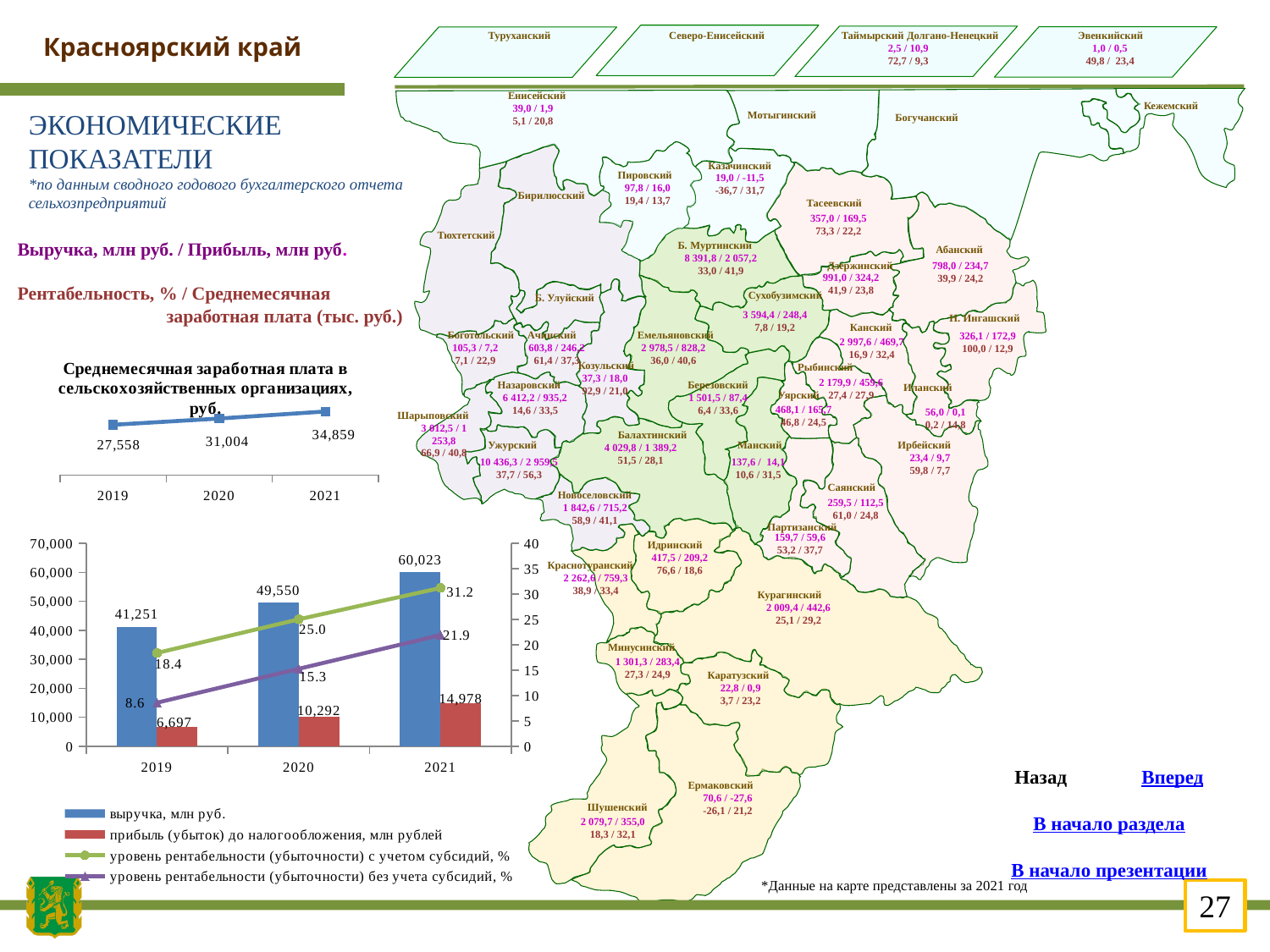
How many series does the legend of the bottom-left combo chart list? 4 In the bottom-left combo chart, what is the уровень рентабельности с учетом субсидий (profitability with subsidies) for 2019? 18.4 In the bottom-left combo chart, what is the value of прибыль (profit) до налогообложения for 2020? 10,292 In the line chart on average monthly salary in agricultural organizations, what is the value for 2021? 34,859 In the bottom-left combo chart, what is the difference between revenue in 2021 and revenue in 2019? 18,772 In the bottom-left combo chart, which year has the lowest profit before taxation? 2019 In the line chart on average monthly salary in agricultural organizations, do the values rise or fall from 2019 to 2021? rise In the bottom-left combo chart, what is the уровень рентабельности без учета субсидий (profitability without subsidies) for 2021? 21.9 In the bottom-left combo chart, what is the value of выручка (revenue), млн руб., for 2021? 60,023 In the line chart on average monthly salary in agricultural organizations, how many years are plotted? 3 In the line chart on average monthly salary in agricultural organizations, what is the value for 2019? 27,558 In the line chart on average monthly salary in agricultural organizations, by how much did the value increase from 2019 to 2020? 3,446